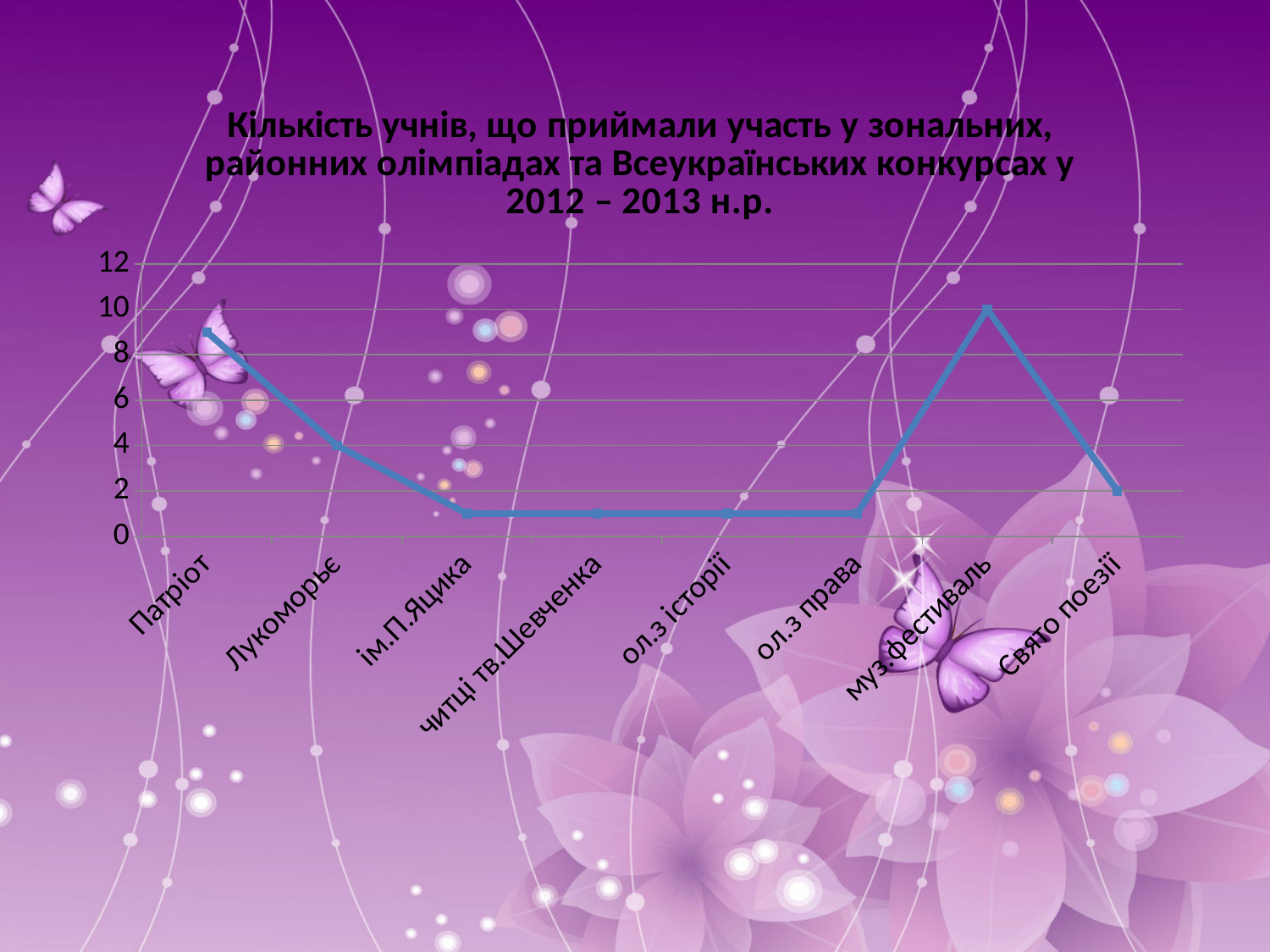
Is the value for ім.П.Яцика greater or less than 2? less Is the value for Патріот greater or less than 8? greater What is the value for муз.фестиваль? 10 Which is larger, the value for Патріот or the value for Свято поезії? Патріот What is the value for Лукоморье? 4 Which category has the highest value? муз.фестиваль What is the difference between the values for муз.фестиваль and Свято поезії? 8 Do the values rise or fall from Патріот to ім.П.Яцика? fall What is the value for Свято поезії? 2 How many categories are plotted along the x axis? 8 Which school year does the chart title refer to? 2012 – 2013 н.р. What kind of chart is shown on the slide? line chart